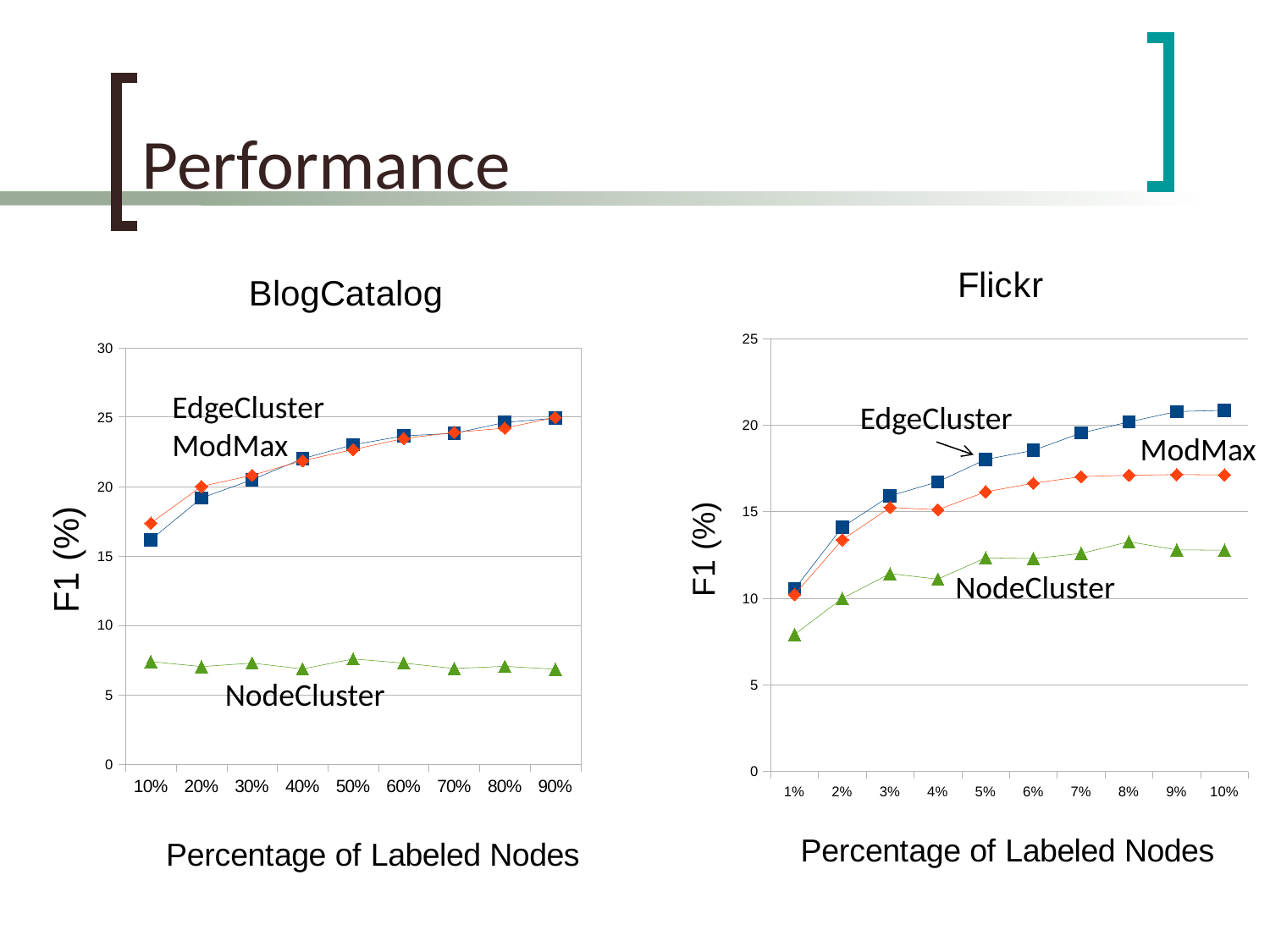
How many points are plotted along the x axis of the Flickr chart? 10 In the BlogCatalog chart, which series is lowest across all percentages of labeled nodes? NodeCluster What is the x-axis label of the BlogCatalog chart? Percentage of Labeled Nodes In the Flickr chart, does the EdgeCluster series generally rise or fall as the percentage of labeled nodes increases? rise In the Flickr chart, which series is higher at 10%, EdgeCluster or ModMax? EdgeCluster What is the y-axis label of the Flickr chart? F1 (%) In the BlogCatalog chart, is the NodeCluster value at 50% greater or less than 10? less What type of chart is the BlogCatalog chart? line chart How many points are plotted along the x axis of the BlogCatalog chart? 9 In the BlogCatalog chart, is the EdgeCluster value at 90% greater or less than 20? greater In the Flickr chart, is the NodeCluster value at 1% greater or less than 10? less